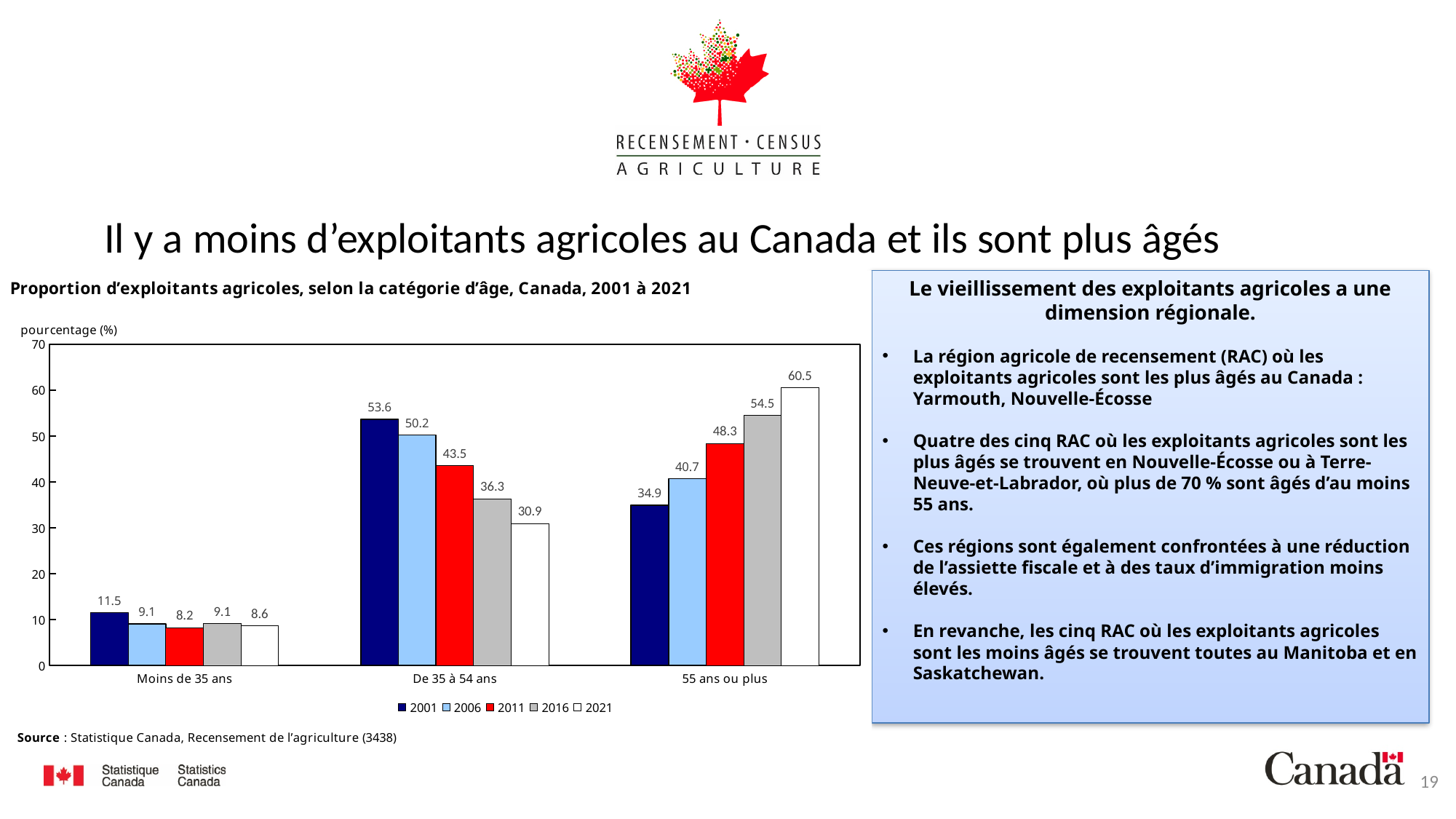
How many age categories are shown on the x axis? 3 Which year has the highest value in the '55 ans ou plus' category? 2021 What is the value for 2021 in the '55 ans ou plus' category? 60.5 Which is larger: the 2016 value for 'De 35 à 54 ans' or the 2016 value for '55 ans ou plus'? 55 ans ou plus What kind of chart is shown on the slide? Bar chart What is the difference between the 2001 and 2021 values in the 'De 35 à 54 ans' category? 22.7 Do the values for the '55 ans ou plus' category rise or fall from 2001 to 2021? Rise What is the value for 2001 in the 'Moins de 35 ans' category? 11.5 What is the value for 2011 in the 'De 35 à 54 ans' category? 43.5 Which year has the lowest value in the 'Moins de 35 ans' category? 2011 What is the title of the chart? Proportion d’exploitants agricoles, selon la catégorie d’âge, Canada, 2001 à 2021 How many series does the legend list? 5